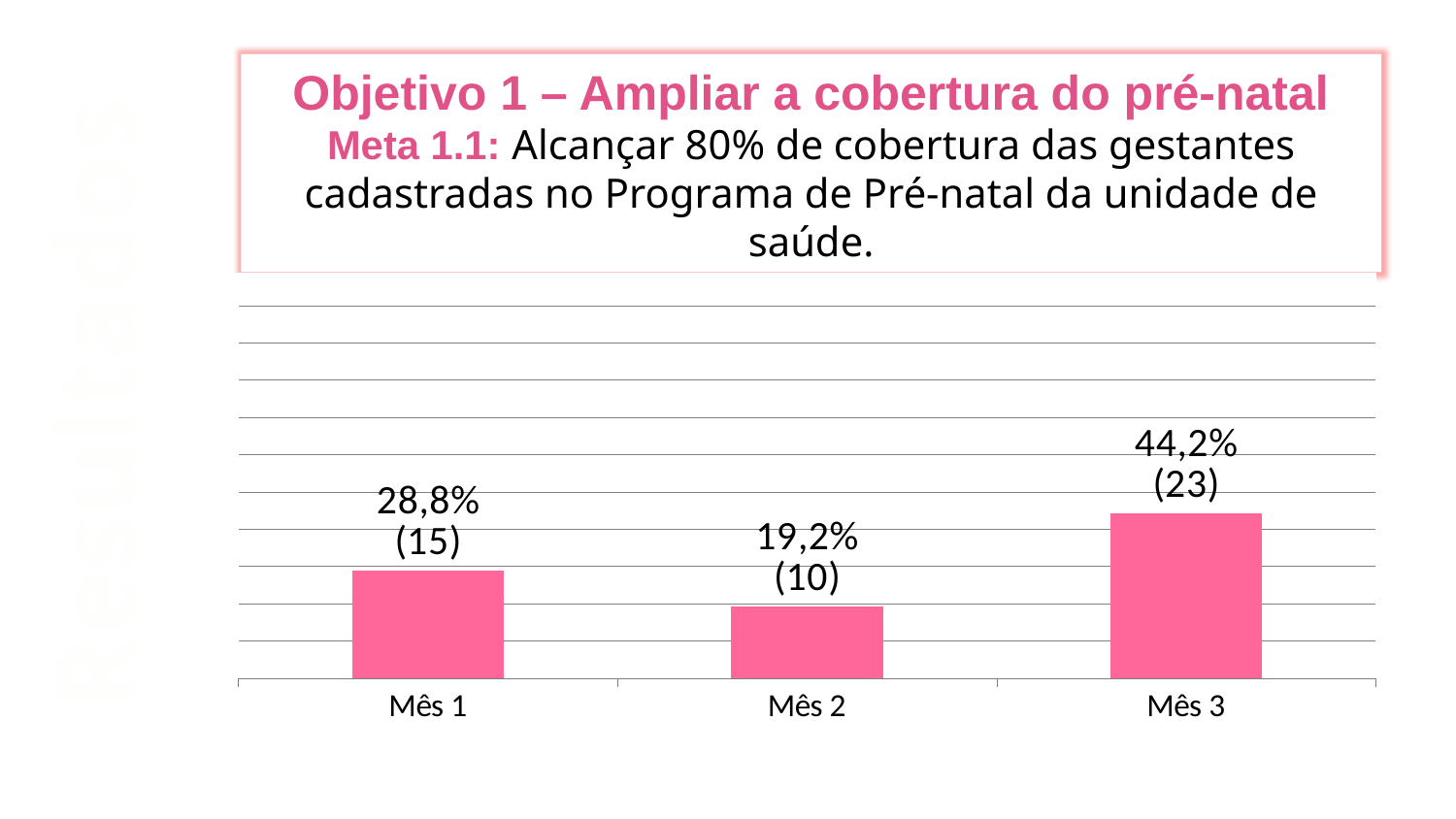
What is the difference in percentage points between Mês 3 and Mês 1? 15,4 What is the percentage value shown for Mês 2? 19,2% What is the percentage value shown for Mês 1? 28,8% How many months (categories) are shown on the chart? 3 Which is larger, the value for Mês 1 or the value for Mês 2? Mês 1 What count is shown in parentheses for Mês 2? 10 Which month has the highest value? Mês 3 What is the difference between the counts for Mês 1 and Mês 2? 5 What count is shown in parentheses for Mês 3? 23 What kind of chart is shown on the slide? Bar chart What is the percentage value shown for Mês 3? 44,2% Which month has the lowest value? Mês 2